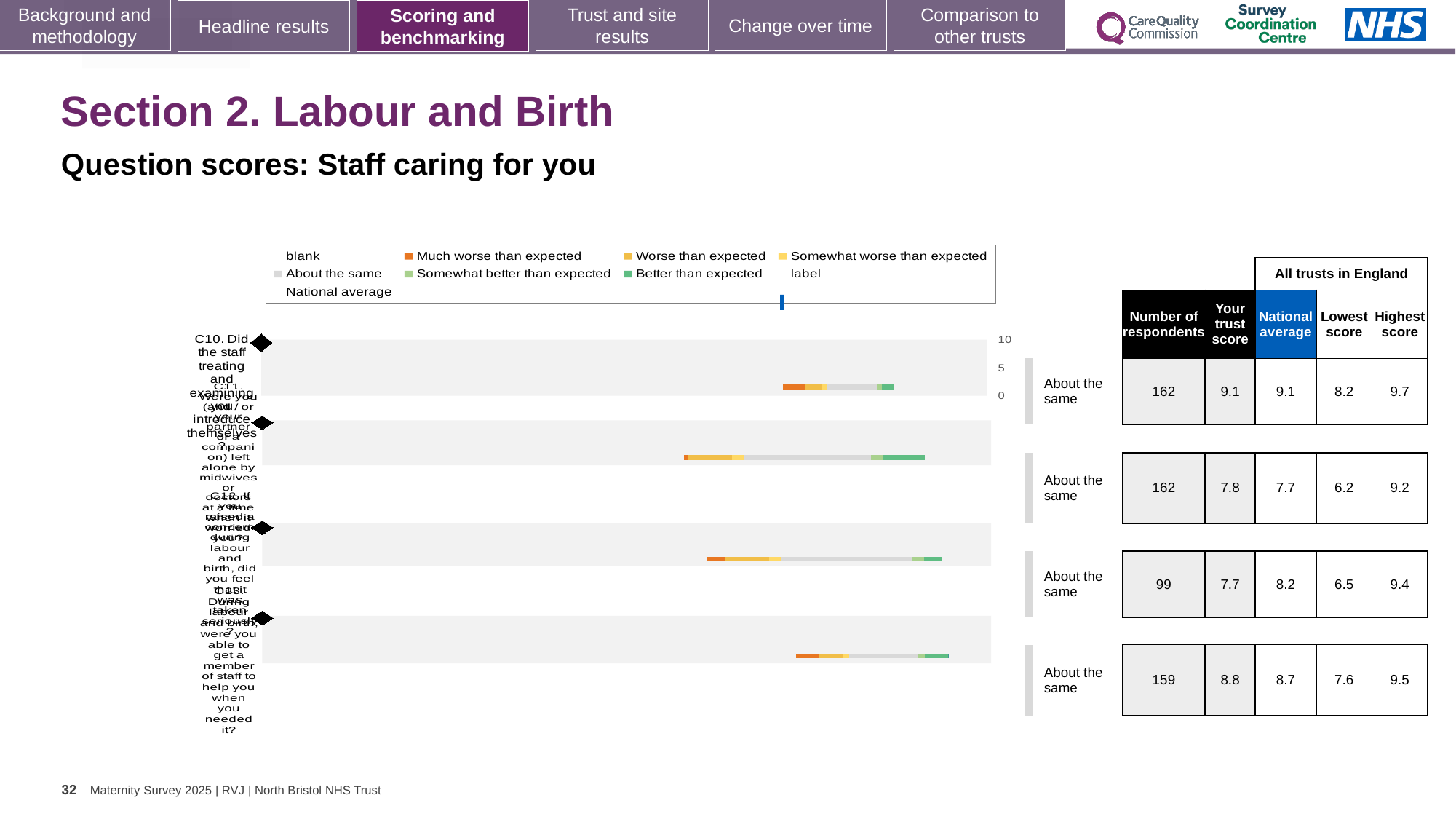
How many question rows are plotted in the chart? 4 Which question row has the lowest 'Your trust score'? the third row, 7.7 For the third question row, which is larger: the trust score or the national average? national average (8.2) In the legend, what does the orange colour represent? Much worse than expected What is the lowest score among all trusts in England for the first question row? 8.2 Which question row has the highest 'Your trust score'? the first (top) row, 9.1 What kind of chart is shown on the slide? bar chart What benchmark category is shown for all four question rows? About the same What is the national average for the fourth (bottom) question row? 8.7 What is the number of respondents for the third question row? 99 For the second question row, what is the difference between the highest score (9.2) and the lowest score (6.2)? 3.0 What is the 'Your trust score' value for the first (top) question row? 9.1